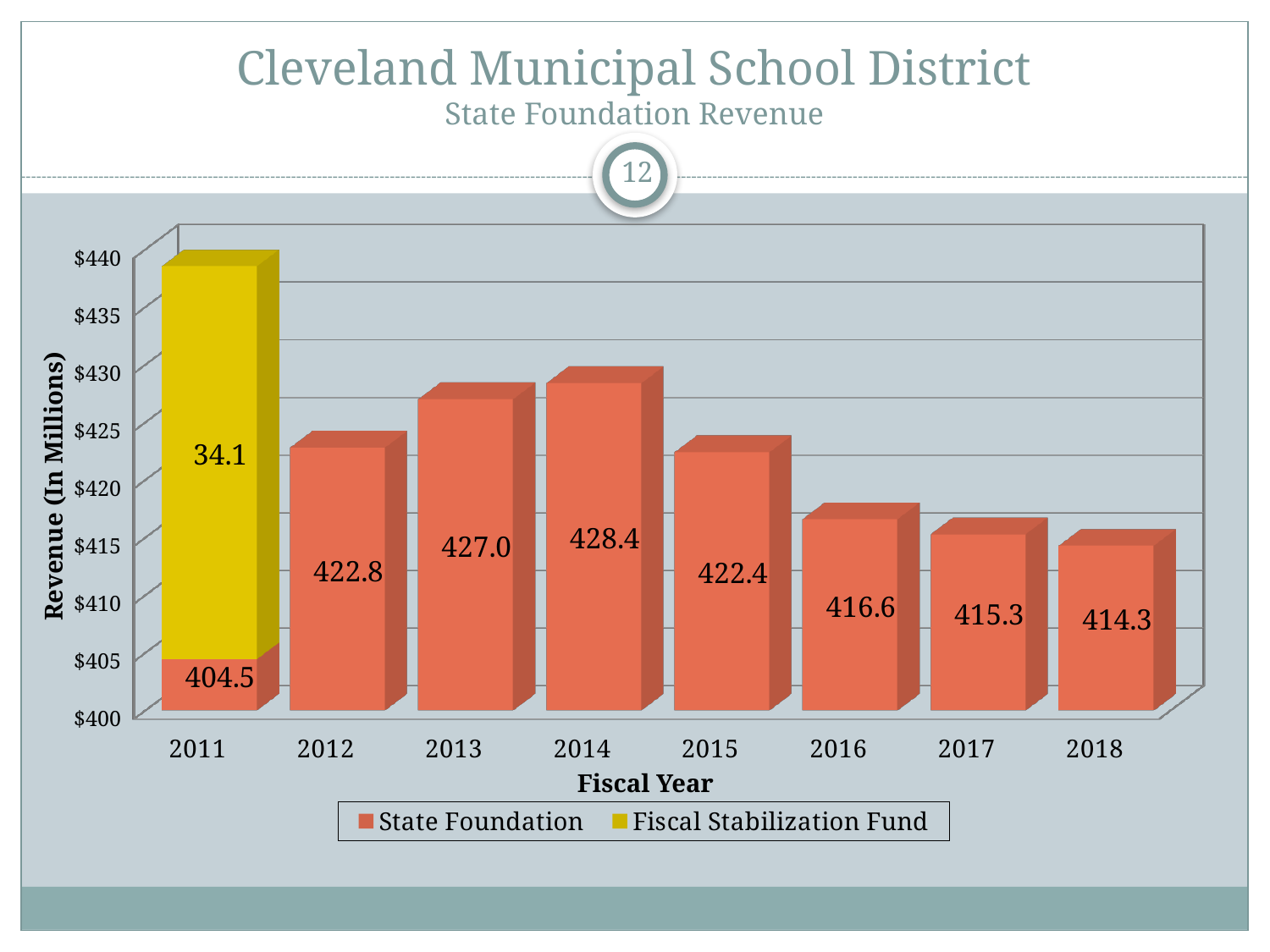
What is the total height of the stacked bar for 2011 (State Foundation plus Fiscal Stabilization Fund)? 438.6 Which is larger, the State Foundation revenue in 2012 or in 2015? 2012 Which fiscal year has the lowest State Foundation revenue? 2011 What kind of chart is shown on the slide? Bar chart What is the State Foundation revenue for fiscal year 2014? 428.4 Which fiscal year has the highest State Foundation revenue? 2014 How many series does the legend list? 2 What is the State Foundation revenue for fiscal year 2018? 414.3 How many fiscal years are shown on the x axis? 8 From 2014 to 2018, do the State Foundation revenue values rise or fall? Fall What is the Fiscal Stabilization Fund value shown for 2011? 34.1 What is the difference between the State Foundation revenue in 2014 and in 2018? 14.1